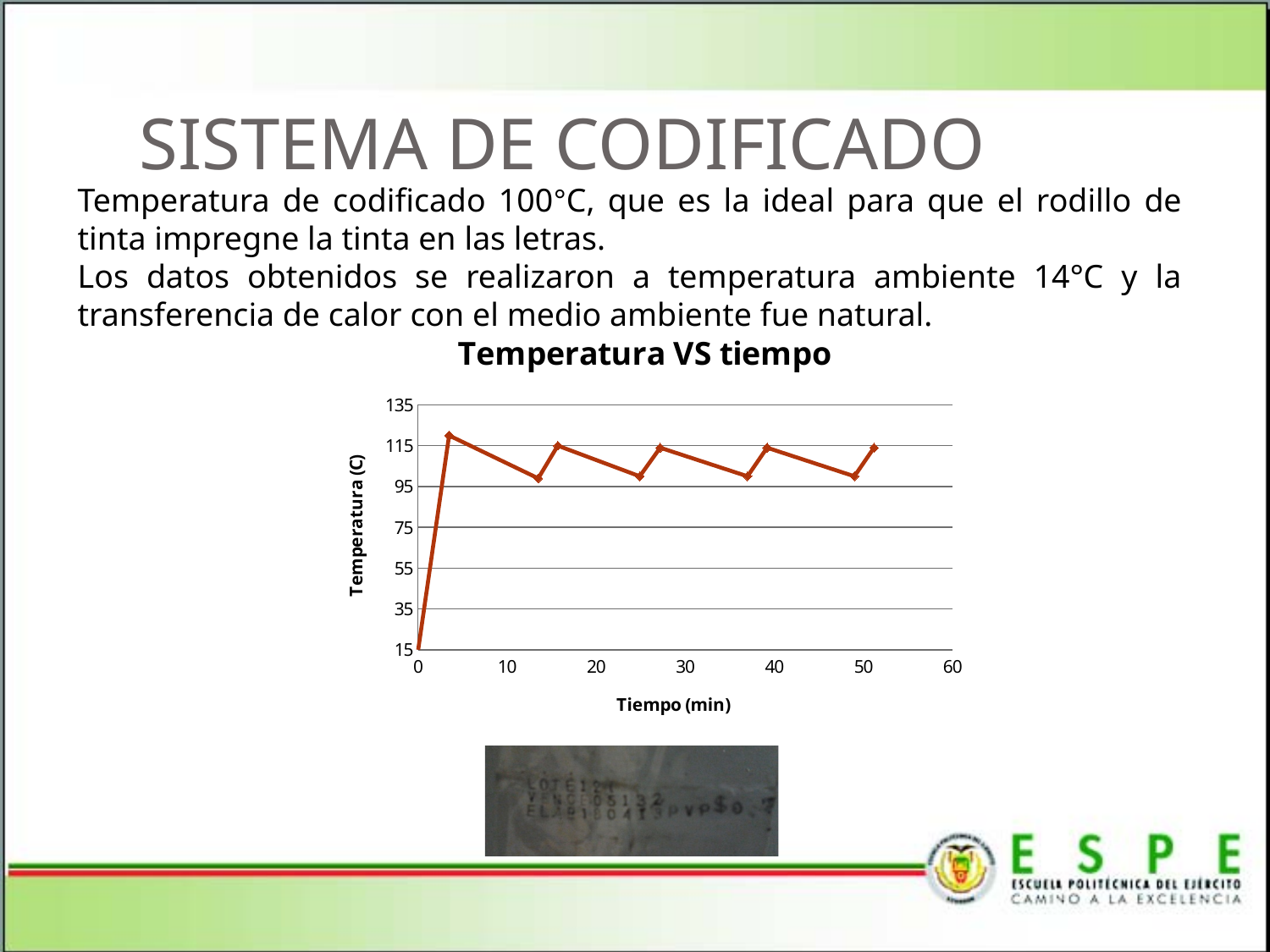
What is the title of the chart? Temperatura VS tiempo At what time is the lowest temperature on the chart recorded? 0 Is the highest temperature reached on the chart greater or less than 115? greater What is the label of the x axis of the chart? Tiempo (min) Is the temperature at about 50 min greater or less than 95? greater Is the temperature at about 25 min greater or less than 75? greater Between 0 and 5 minutes, does the temperature rise or fall? rise What kind of chart is shown on the slide? line chart How many data points are plotted on the line? 10 Which is larger, the temperature at time 0 min or the temperature at about 4 min? about 4 min